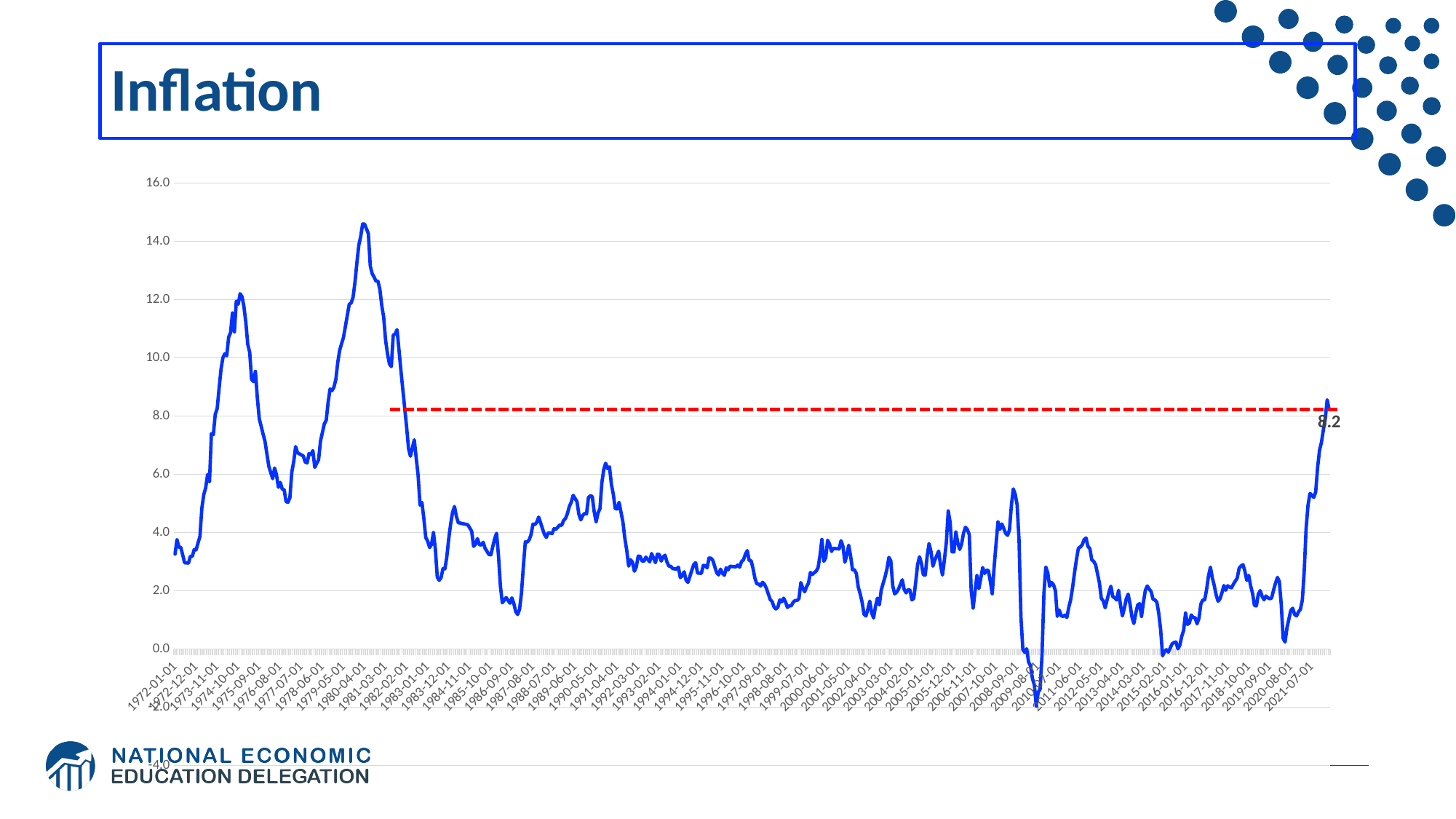
Is the peak of the blue line around 1974-10-01 greater or less than 10.0? greater What is the highest value labelled on the vertical axis? 16.0 What value is printed next to the red dashed horizontal line? 8.2 What is the title of the slide containing the chart? Inflation What kind of chart is shown on the slide? line chart Which peak is higher: the one around 1974 or the one around 1980? the one around 1980 Is the lowest point of the blue line around 2009-08-01 greater or less than 0.0? less Does the blue line rise or fall between 1980 and 1983? fall Is the value of the blue line around 1986-09-01 greater or less than 2.0? less What colour is the dashed horizontal reference line? red Does the blue line rise or fall between 2020-08-01 and the end of the series in 2021? rise